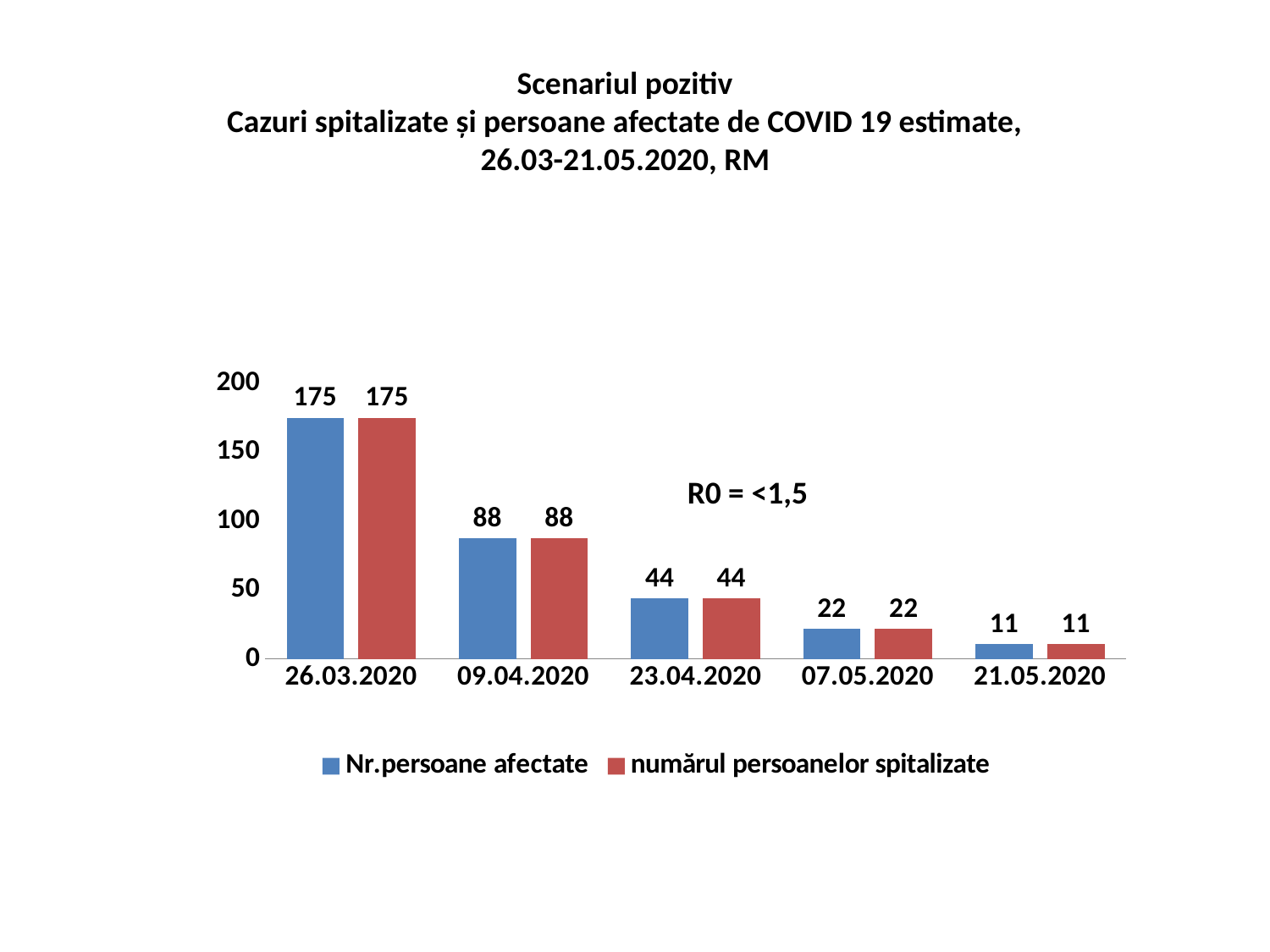
How many series does the legend list? 2 What is the value of Nr.persoane afectate for 26.03.2020? 175 What kind of chart is shown on the slide? bar chart Which is larger: the Nr.persoane afectate value for 07.05.2020 or for 23.04.2020? 23.04.2020 What is the value of numărul persoanelor spitalizate for 09.04.2020? 88 How many dates are shown on the x axis? 5 What is the difference between the Nr.persoane afectate values for 26.03.2020 and 09.04.2020? 87 Do the values for Nr.persoane afectate rise or fall from 26.03.2020 to 21.05.2020? fall What is the value of numărul persoanelor spitalizate for 21.05.2020? 11 Which date has the lowest value for numărul persoanelor spitalizate? 21.05.2020 Which date has the highest value for Nr.persoane afectate? 26.03.2020 What is the value of Nr.persoane afectate for 23.04.2020? 44